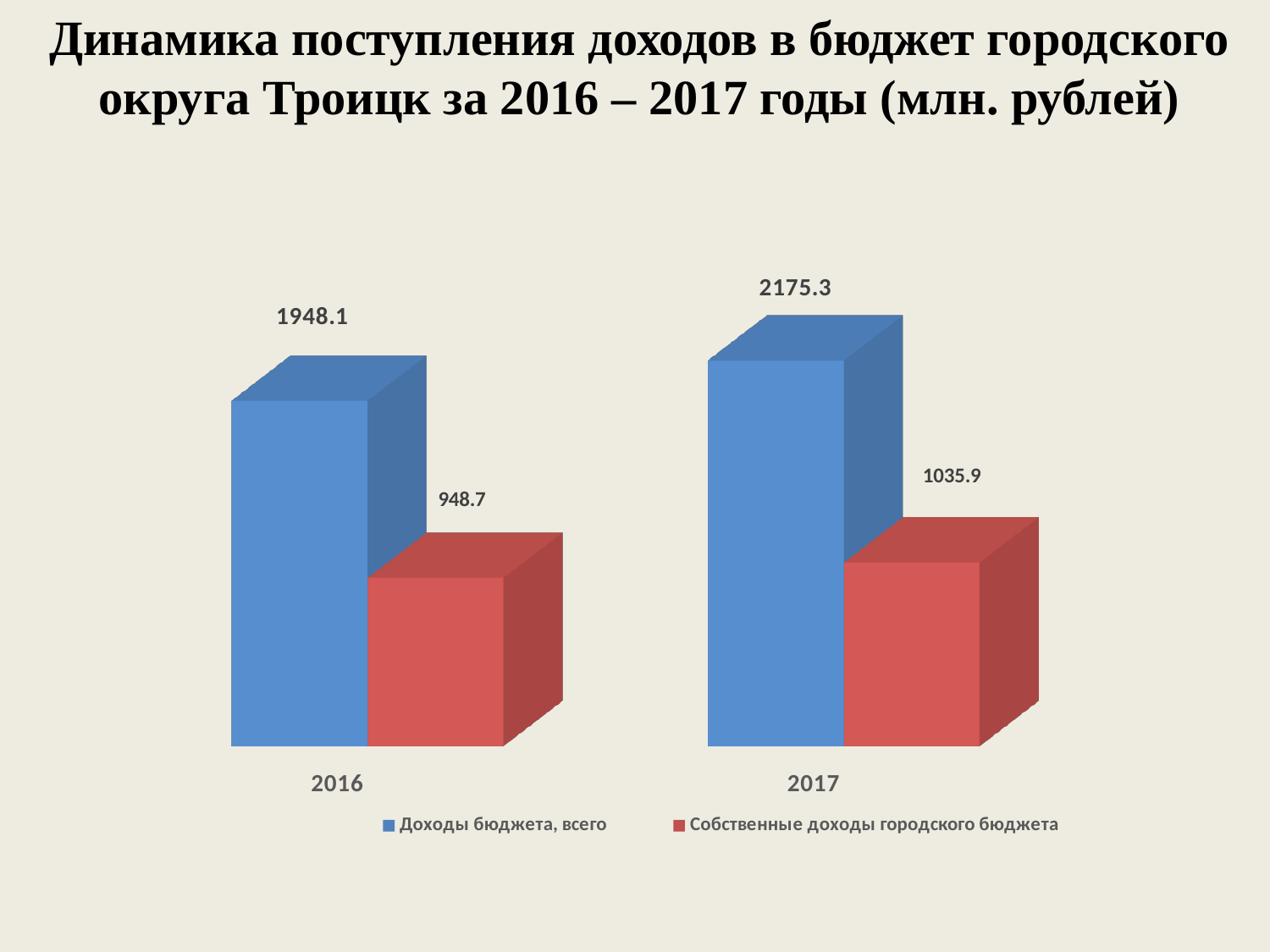
What is the value of "Доходы бюджета, всего" for 2017? 2175.3 What is the value of "Собственные доходы городского бюджета" for 2017? 1035.9 Which year has the lowest value for "Собственные доходы городского бюджета"? 2016 How many years are shown on the x axis? 2 What kind of chart is shown on the slide? Bar chart Which is larger in 2017: "Доходы бюджета, всего" or "Собственные доходы городского бюджета"? Доходы бюджета, всего What is the value of "Собственные доходы городского бюджета" for 2016? 948.7 By how much did "Доходы бюджета, всего" increase from 2016 to 2017? 227.2 What is the value of "Доходы бюджета, всего" for 2016? 1948.1 What is the difference between "Доходы бюджета, всего" and "Собственные доходы городского бюджета" in 2016? 999.4 Which year has the highest value for "Доходы бюджета, всего"? 2017 How many series does the legend list? 2